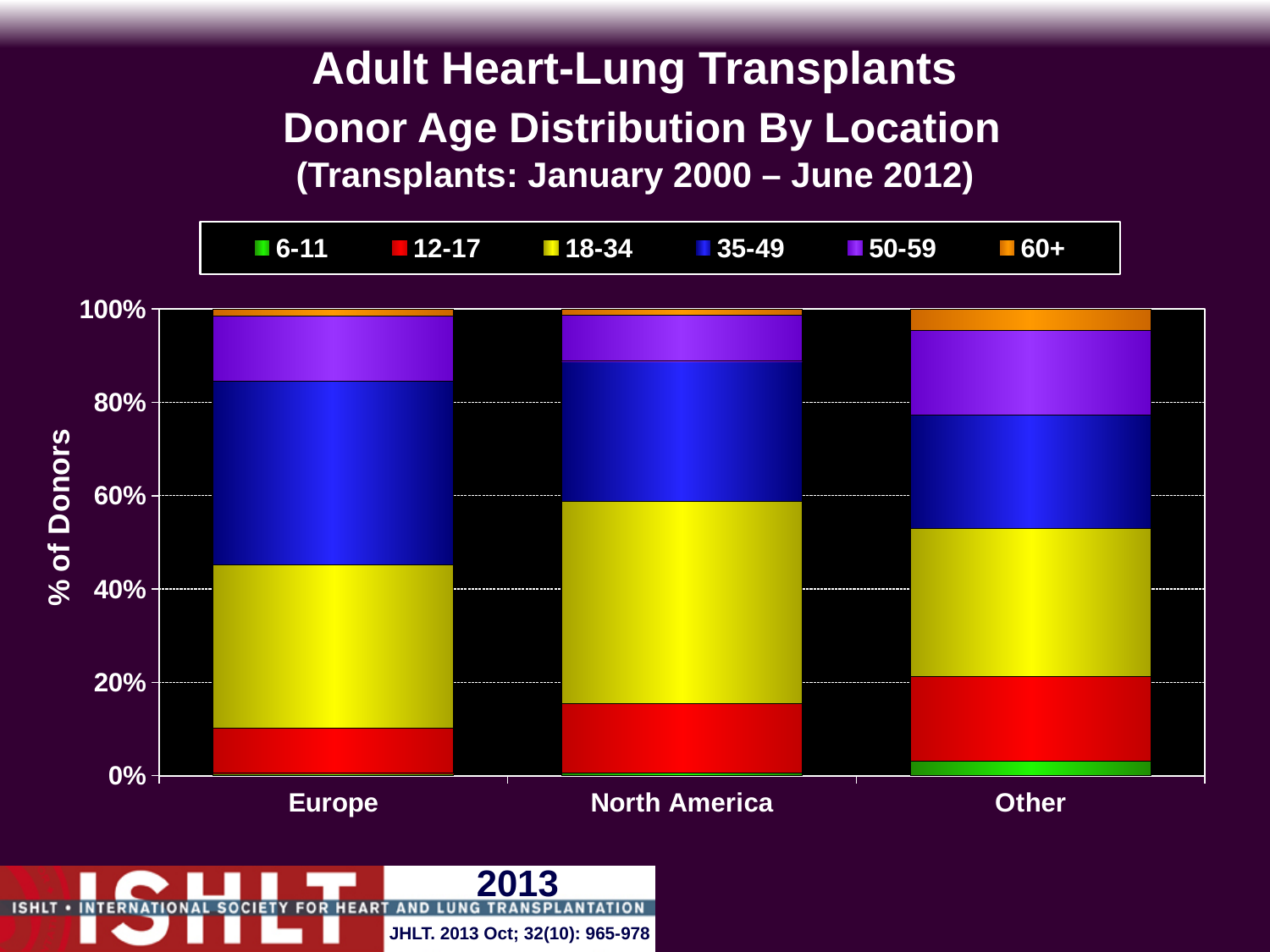
Which location has the largest share of donors aged 50-59? Other How many donor age groups does the legend list? 6 What kind of chart is shown on the slide? Stacked bar chart What is the label of the y axis? % of Donors Which location has the largest share of donors aged 12-17? Other How many locations are shown on the x axis? 3 Which age group is shown in yellow in the legend? 18-34 Is the share of donors aged 18-34 larger for Europe or for North America? North America Which location has the largest share of donors aged 35-49? Europe Is the share of donors aged 60+ larger for Europe or for Other? Other Is the share of donors aged 18-34 in Europe greater or less than 20%? greater Is the share of donors aged 12-17 in North America greater or less than 20%? less